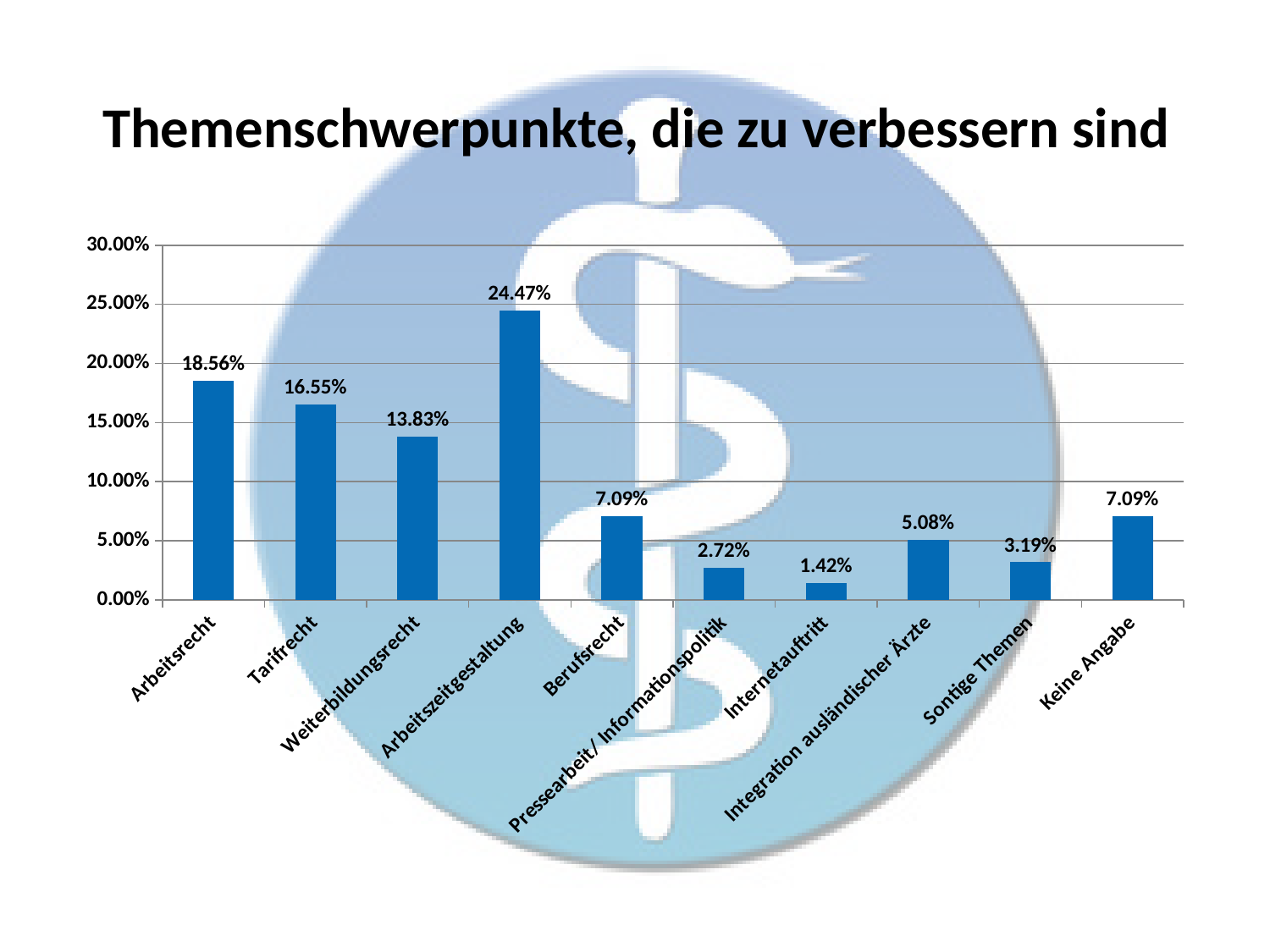
Is the value for Sontige Themen greater or less than 5.00%? less Which category has the lowest value? Internetauftritt What is the value for Weiterbildungsrecht? 13.83% Which is larger, the value for Tarifrecht or the value for Berufsrecht? Tarifrecht What is the value for Integration ausländischer Ärzte? 5.08% Which category has the highest value? Arbeitszeitgestaltung How many categories are shown on the x axis? 10 What kind of chart is shown on the slide? bar chart What is the difference between the values for Arbeitszeitgestaltung and Arbeitsrecht? 5.91% What is the value for Arbeitsrecht? 18.56% What is the difference between the values for Tarifrecht and Weiterbildungsrecht? 2.72% What is the title of the chart? Themenschwerpunkte, die zu verbessern sind